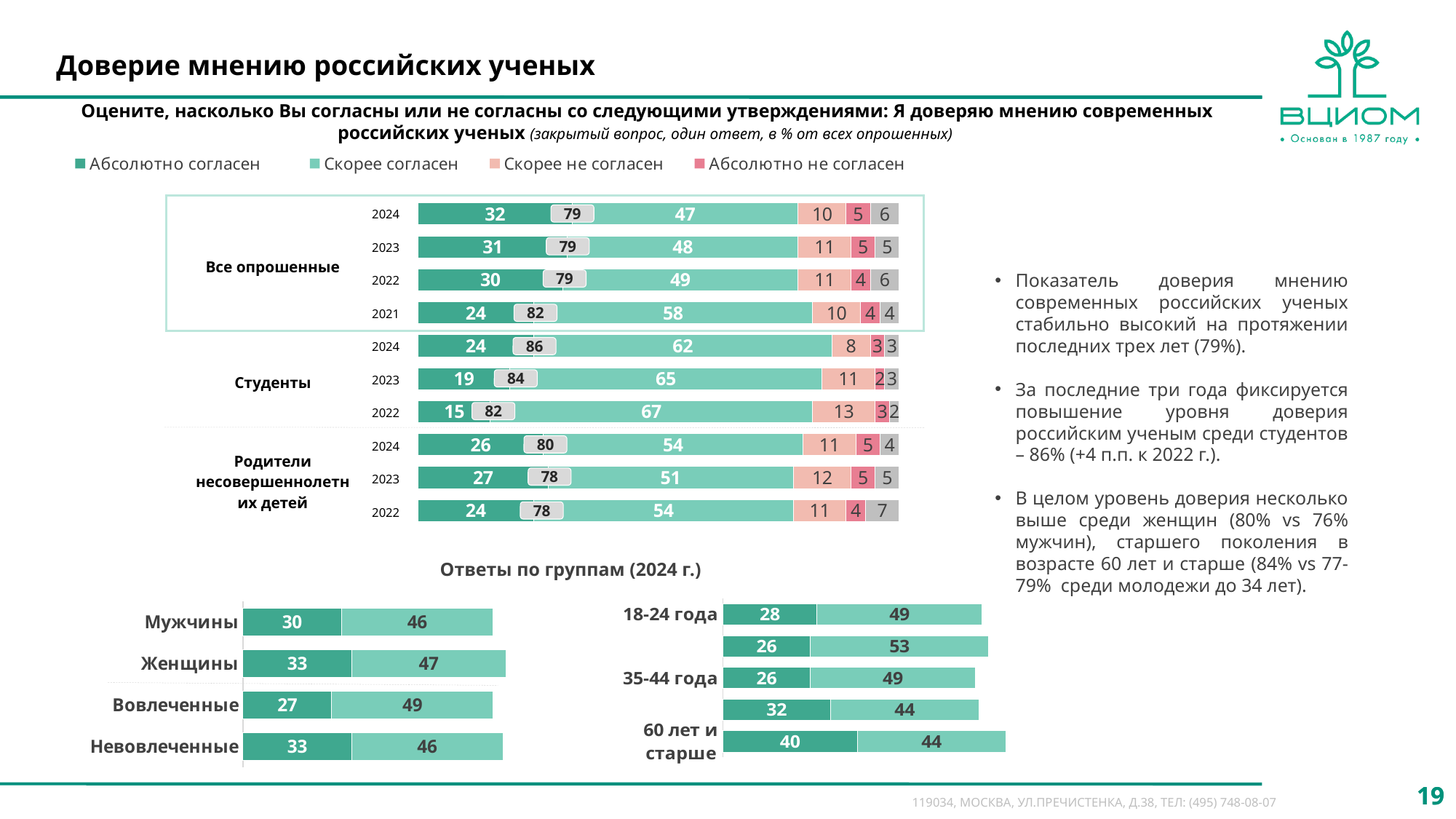
In the bottom-left chart 'Ответы по группам (2024 г.)', what is the 'Абсолютно согласен' value for 'Женщины'? 33 In the bottom-right chart, what is the 'Абсолютно согласен' value for '60 лет и старше'? 40 In the top chart, what is the value of 'Абсолютно не согласен' for 'Родители несовершеннолетних детей' in 2023? 5 In the bottom-right chart, what is the total of the two segments for '18-24 года'? 77 In the top chart, what is the value of 'Скорее согласен' for 'Студенты' in 2022? 67 What kind of chart is the top chart? Stacked bar chart In the top chart, what is the value of 'Абсолютно согласен' for 'Все опрошенные' in 2024? 32 In the top chart, which is larger: 'Скорее не согласен' for 'Студенты' in 2022 or for 'Студенты' in 2024? Студенты 2022 How many series does the legend of the top chart list? 4 In the top chart, which year has the highest 'Скорее согласен' value among 'Студенты'? 2022 In the top chart, what is the difference between the 'Абсолютно согласен' values for 'Все опрошенные' in 2024 and 2021? 8 In the bottom-left chart 'Ответы по группам (2024 г.)', how many categories are shown? 4